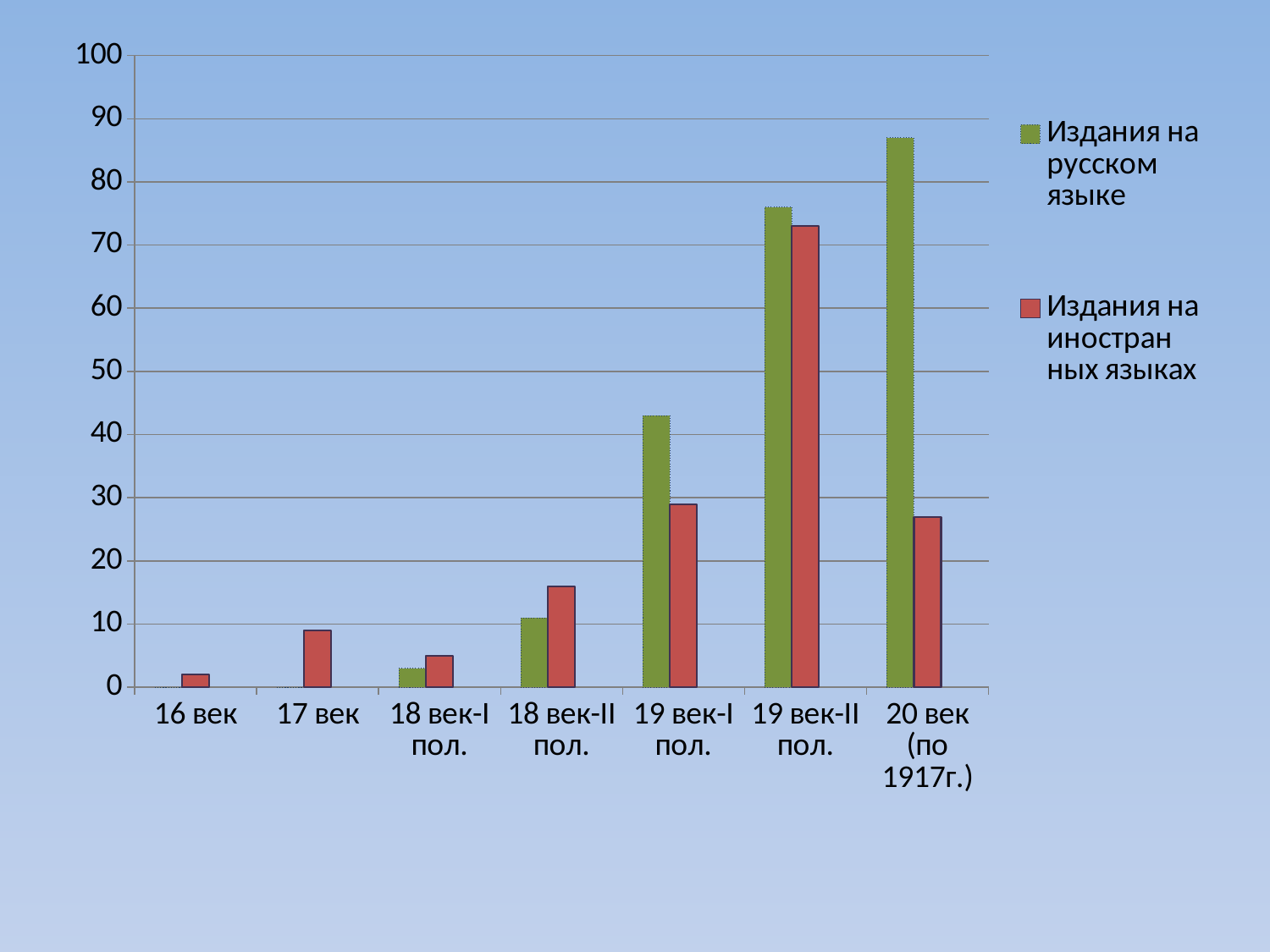
How many categories are shown on the x axis? 7 Do the values for Издания на русском языке rise or fall from 16 век to 20 век (по 1917г.)? rise Which category has the highest value for Издания на иностранных языках? 19 век-II пол. Is the value for Издания на русском языке in 20 век (по 1917г.) greater or less than 80? greater Is the value for Издания на русском языке in 19 век-I пол. greater or less than 40? greater How many series does the legend list? 2 Which category has the lowest value for Издания на иностранных языках? 16 век Which category has the highest value for Издания на русском языке? 20 век (по 1917г.) Is the value for Издания на иностранных языках in 20 век (по 1917г.) greater or less than 30? less What kind of chart is shown on the slide? bar chart In 20 век (по 1917г.), which series has the larger value: Издания на русском языке or Издания на иностранных языках? Издания на русском языке